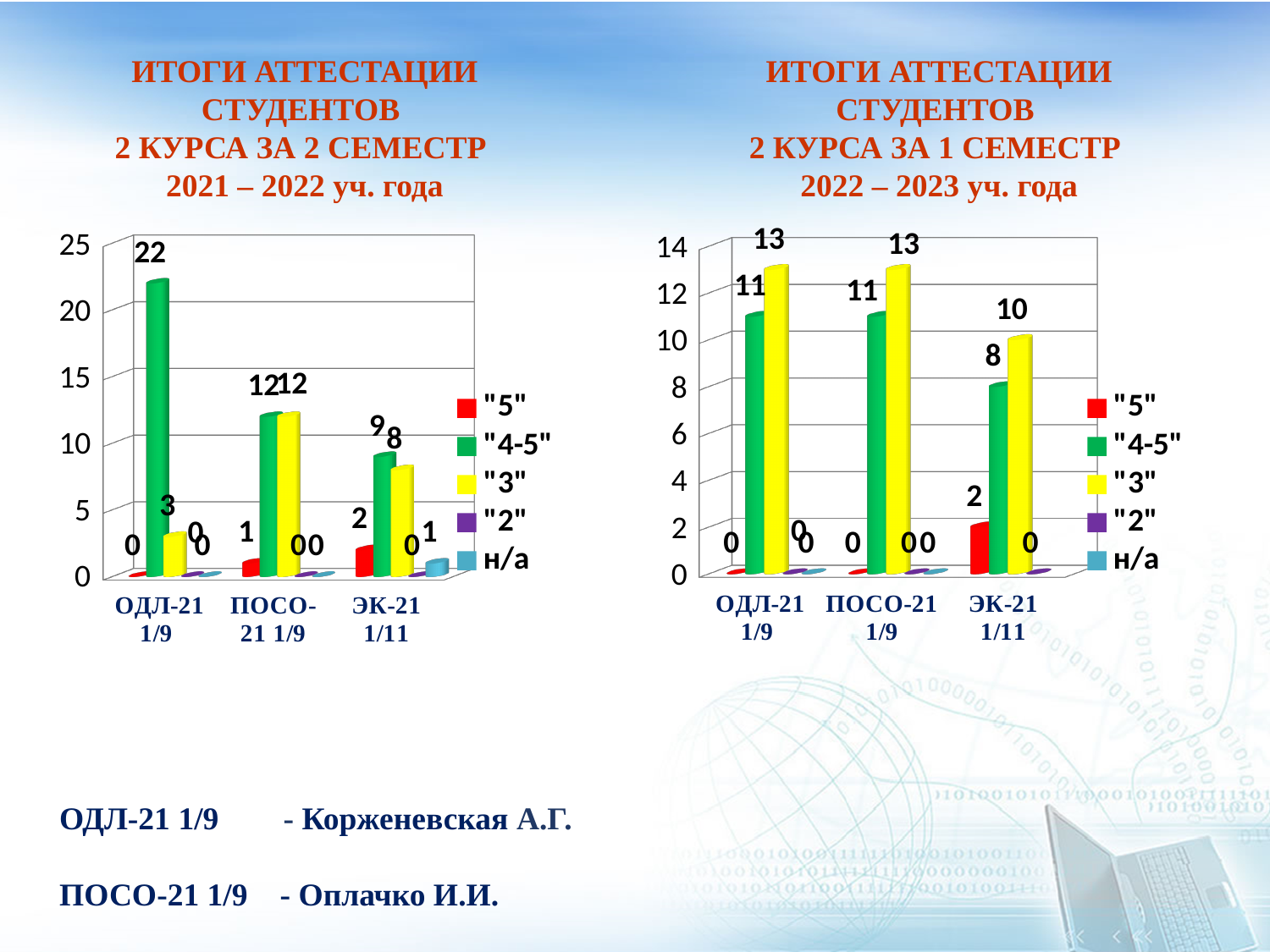
In the left chart (2 семестр 2021 – 2022), which group has the highest "4-5" value? ОДЛ-21 1/9 What type of chart is the left chart? bar chart How many series does the legend of the right chart list? 5 In the right chart (1 семестр 2022 – 2023), what is the value of "3" for ОДЛ-21 1/9? 13 In the right chart (1 семестр 2022 – 2023), which group has the lowest "3" value? ЭК-21 1/11 In the right chart (1 семестр 2022 – 2023), what is the value of "4-5" for ЭК-21 1/11? 8 In the left chart (2 семестр 2021 – 2022), what is the value of "5" for ПОСО-21 1/9? 1 In the right chart (1 семестр 2022 – 2023), is the "3" value for ЭК-21 1/11 larger or smaller than its "4-5" value? larger In the left chart (2 семестр 2021 – 2022), what is the value of "3" for ЭК-21 1/11? 8 In the right chart (1 семестр 2022 – 2023), what is the value of "5" for ЭК-21 1/11? 2 In the left chart (2 семестр 2021 – 2022), what is the value of "4-5" for ОДЛ-21 1/9? 22 In the left chart (2 семестр 2021 – 2022), what is the difference between the "4-5" values of ОДЛ-21 1/9 and ПОСО-21 1/9? 10